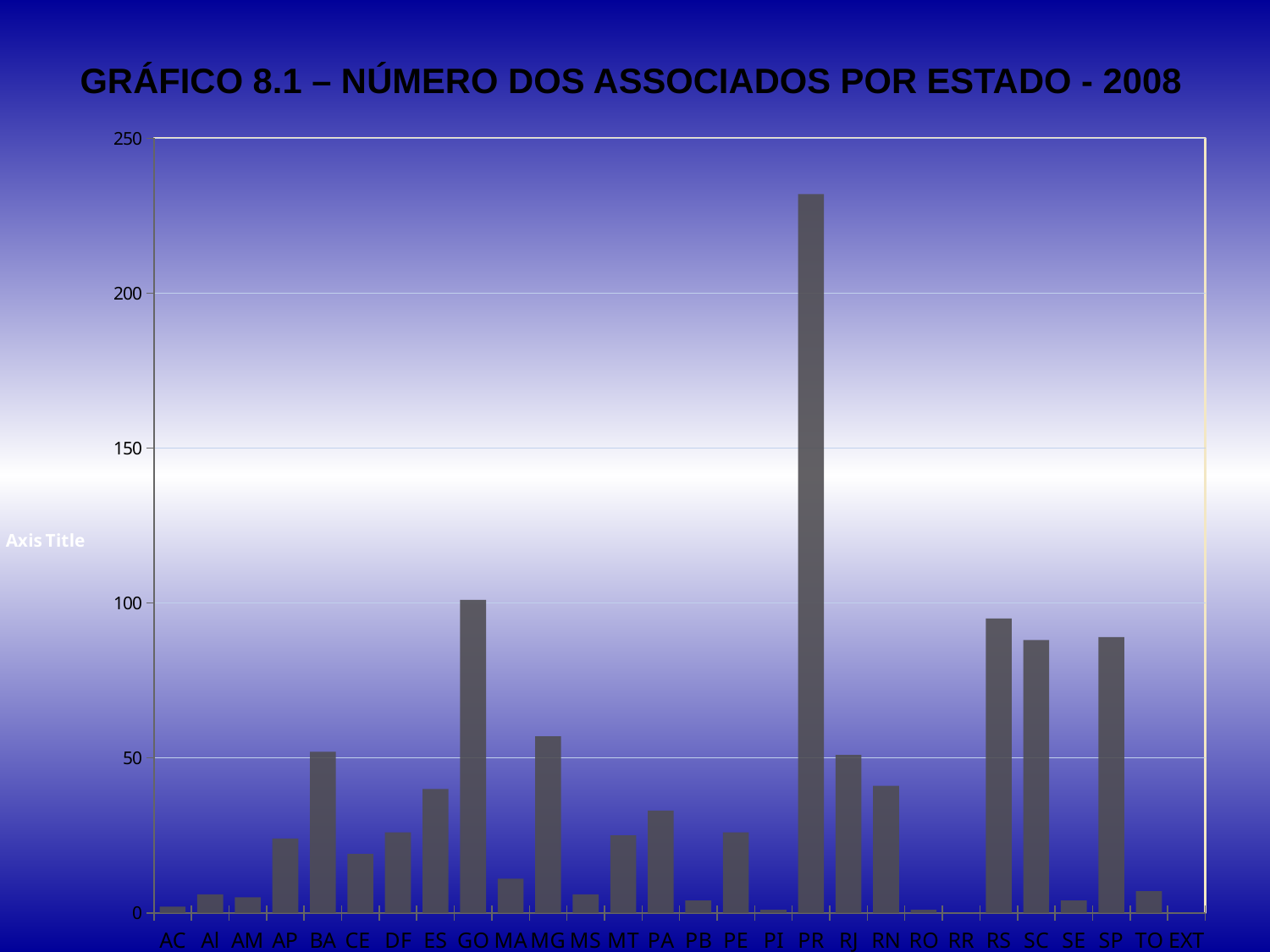
Is the value for SP greater or less than 100? less Which state has the highest number of associados in the chart? PR Is the value for PA greater or less than 50? less Which is larger, the value for PR or the value for GO? PR What kind of chart is shown on the slide? bar chart Is the value for RS greater or less than 100? less How many categories are shown along the x axis? 28 Which is larger, the value for GO or the value for MG? GO What is the title of the chart? GRÁFICO 8.1 – NÚMERO DOS ASSOCIADOS POR ESTADO - 2008